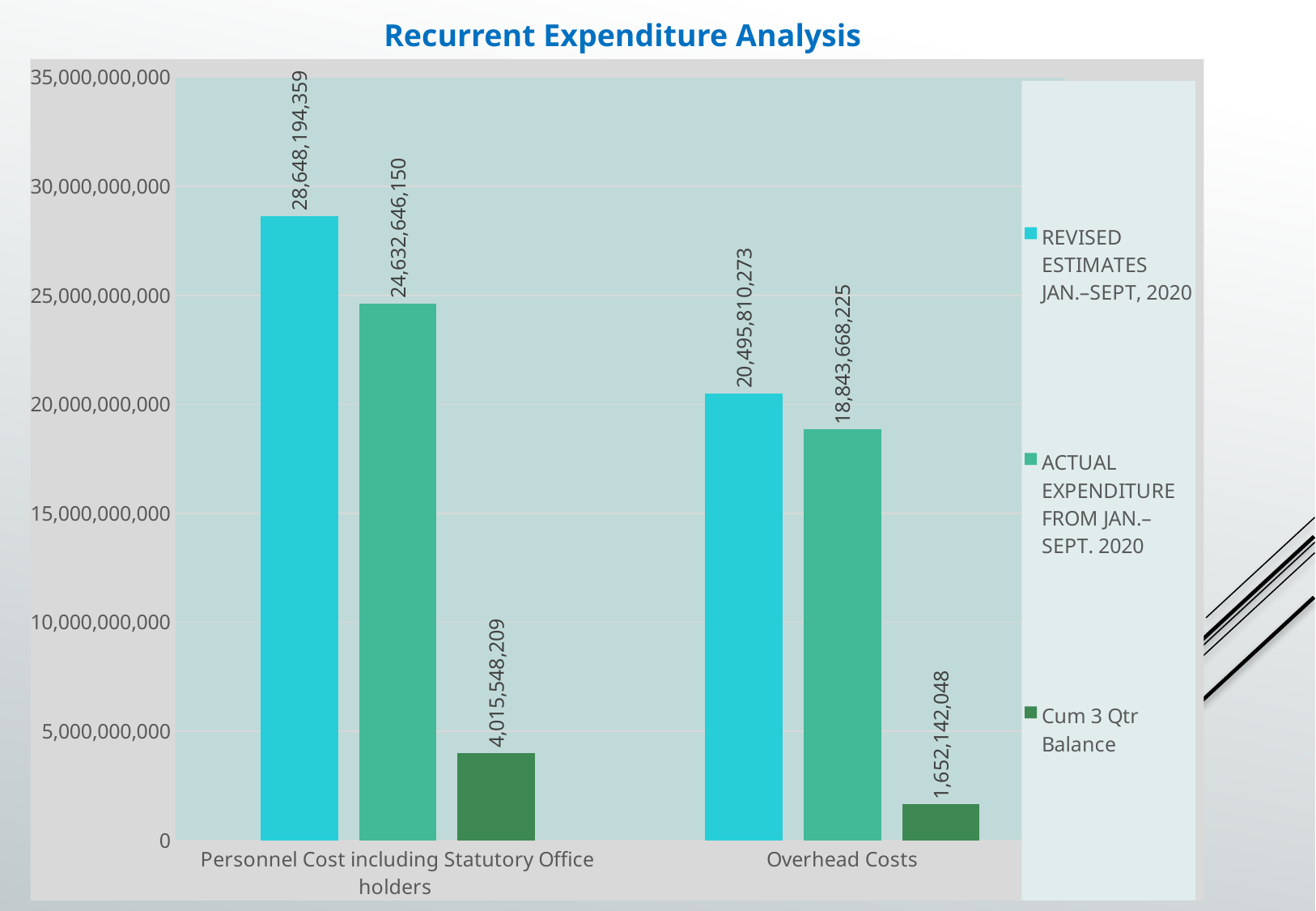
Which category has the lowest Cum 3 Qtr Balance? Overhead Costs Which is larger for Overhead Costs: REVISED ESTIMATES JAN.–SEPT, 2020 or ACTUAL EXPENDITURE FROM JAN.–SEPT. 2020? REVISED ESTIMATES JAN.–SEPT, 2020 What is the chart's title? Recurrent Expenditure Analysis What is the Cum 3 Qtr Balance for Overhead Costs? 1,652,142,048 What type of chart is shown on the slide? Bar chart How many categories are shown on the x axis? 2 How many series does the legend list? 3 What is the value of REVISED ESTIMATES JAN.–SEPT, 2020 for Personnel Cost including Statutory Office holders? 28,648,194,359 What is the Cum 3 Qtr Balance for Personnel Cost including Statutory Office holders? 4,015,548,209 What is the value of ACTUAL EXPENDITURE FROM JAN.–SEPT. 2020 for Overhead Costs? 18,843,668,225 Which category has the highest REVISED ESTIMATES JAN.–SEPT, 2020 value? Personnel Cost including Statutory Office holders What is the difference between the REVISED ESTIMATES JAN.–SEPT, 2020 values for Personnel Cost including Statutory Office holders and Overhead Costs? 8,152,384,086